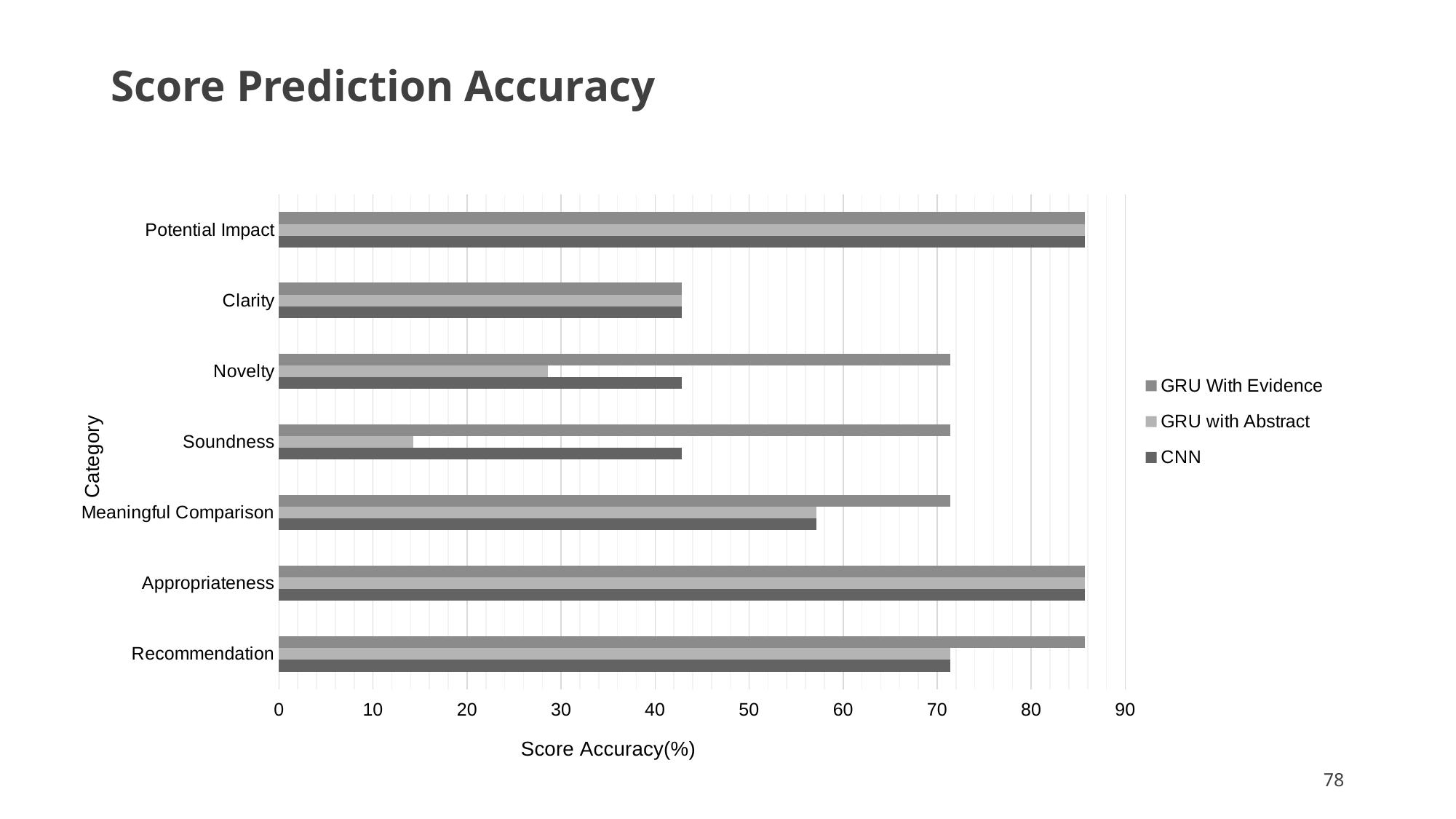
How many categories are listed on the vertical axis of the chart? 7 Is the CNN value for Potential Impact greater or less than 80? greater For Novelty, which is larger: the GRU With Evidence value or the GRU with Abstract value? GRU With Evidence Is the GRU With Evidence value for Recommendation greater or less than 80? greater How many series does the chart's legend list? 3 Is the GRU with Abstract value for Novelty greater or less than 40? less Which category has the lowest GRU with Abstract value? Soundness What kind of chart is shown on the slide? Bar chart What is the label of the horizontal axis of the chart? Score Accuracy(%) For Soundness, which is larger: the CNN value or the GRU with Abstract value? CNN